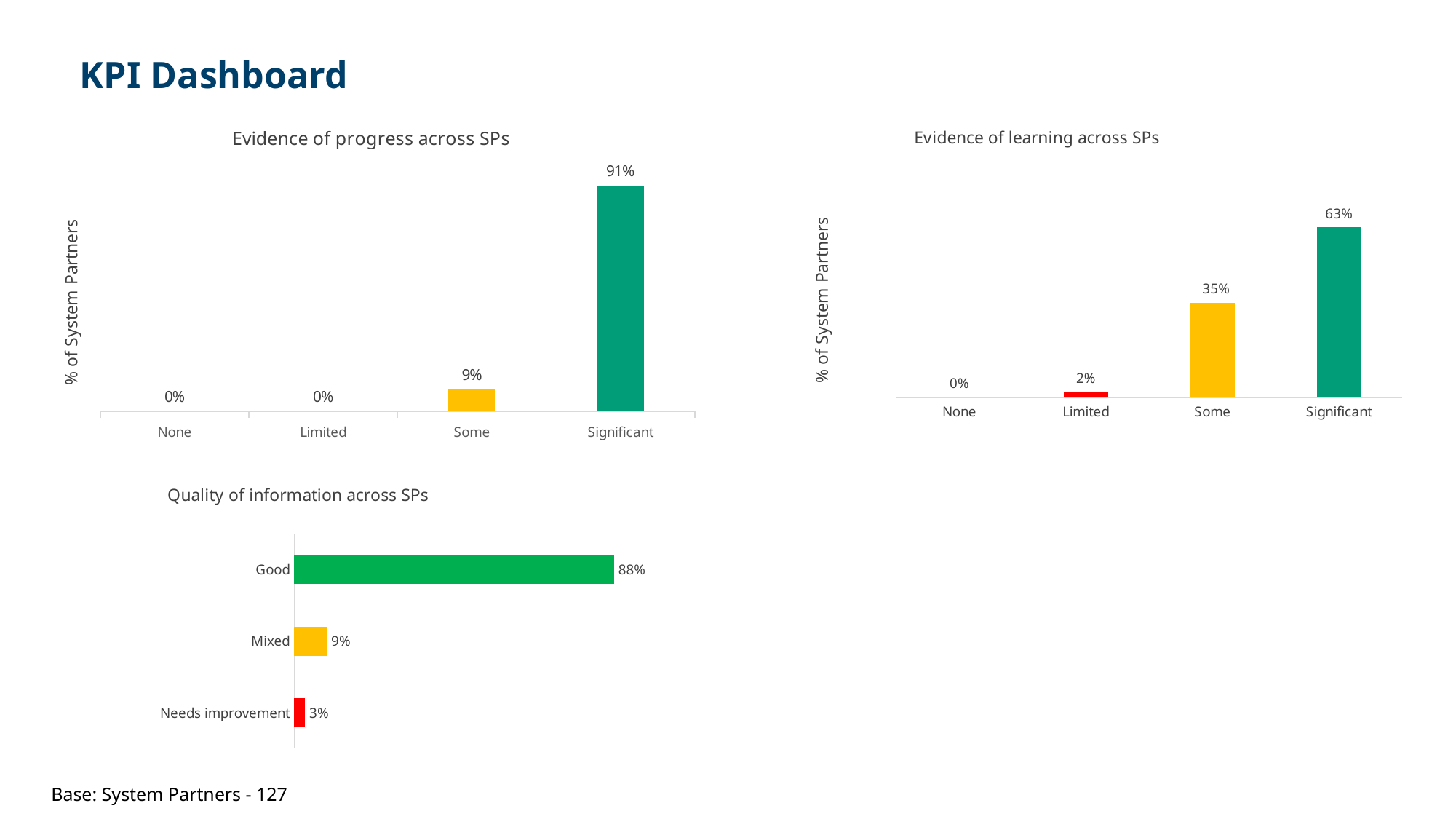
How many categories are shown in the 'Quality of information across SPs' chart? 3 What kind of chart is 'Quality of information across SPs'? Bar chart In the 'Evidence of learning across SPs' chart, which category has the highest value? Significant In the 'Evidence of learning across SPs' chart, what is the difference between the values for Significant and Some? 28% In the 'Evidence of learning across SPs' chart, what is the value for Limited? 2% In the 'Evidence of learning across SPs' chart, do the values rise or fall from None to Significant? Rise In the 'Evidence of progress across SPs' chart, what is the value for Significant? 91% In the 'Quality of information across SPs' chart, which category has the lowest value? Needs improvement In the 'Quality of information across SPs' chart, what is the difference between the values for Good and Mixed? 79% In the 'Evidence of learning across SPs' chart, what is the value for Some? 35% Which is larger: the value for Significant in 'Evidence of progress across SPs' or the value for Significant in 'Evidence of learning across SPs'? Evidence of progress across SPs In the 'Evidence of progress across SPs' chart, what is the value for Some? 9%